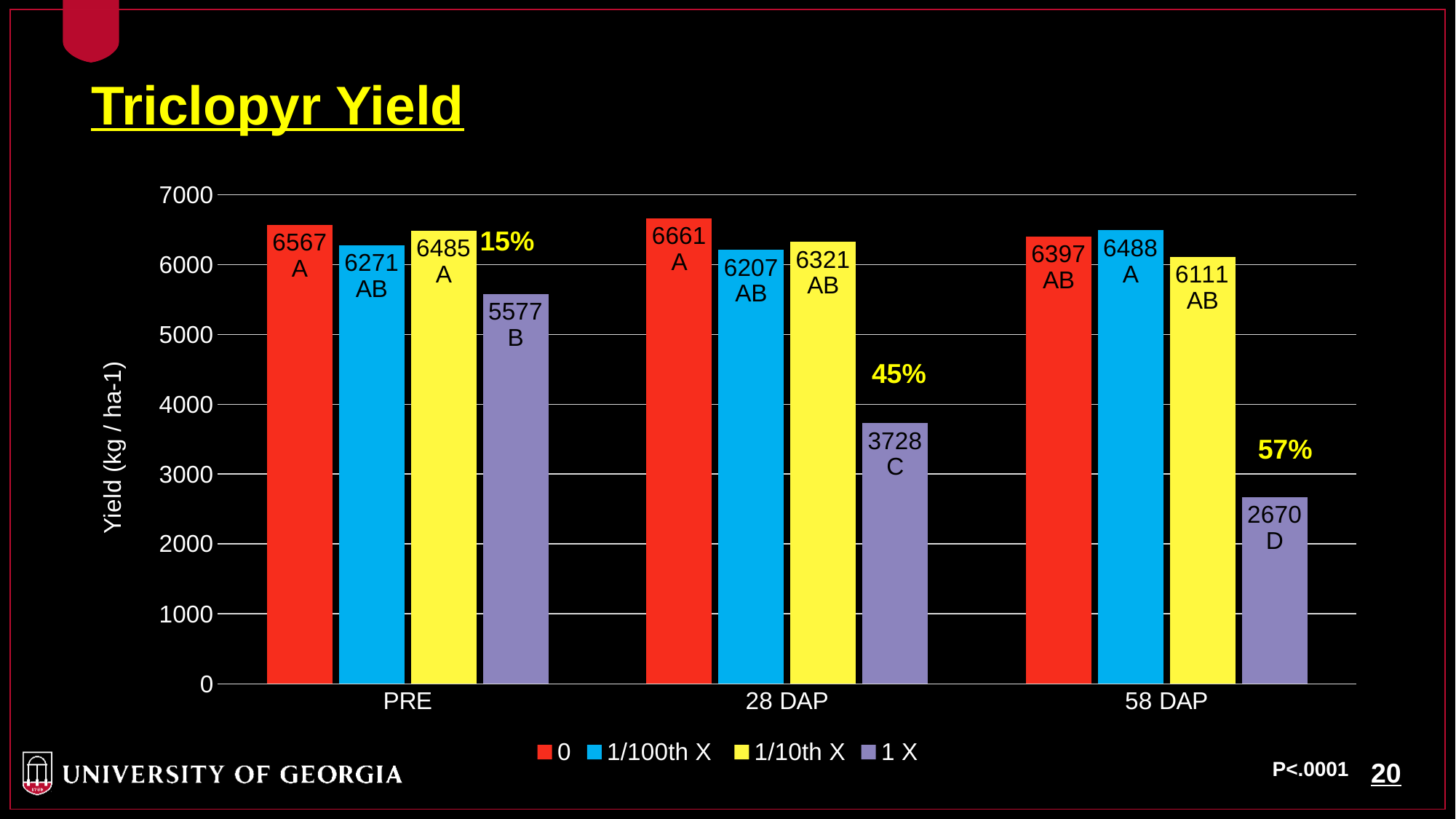
What is the yield for the 0 series at PRE? 6567 Which timing has the lowest yield for the 1 X series? 58 DAP What is the difference between the 0 series and the 1 X series at 58 DAP? 3727 What is the yield for the 1 X series at 28 DAP? 3728 What kind of chart is shown on the slide? bar chart Is the yield for the 1 X series at 58 DAP greater or less than 3000? less How many series does the legend list? 4 How many timing categories are shown on the x axis? 3 Which is larger at PRE, the 1/100th X yield or the 1/10th X yield? 1/10th X Which series has the highest yield at 28 DAP? 0 What is the yield for the 1/10th X series at 58 DAP? 6111 What is the title of the chart? Triclopyr Yield